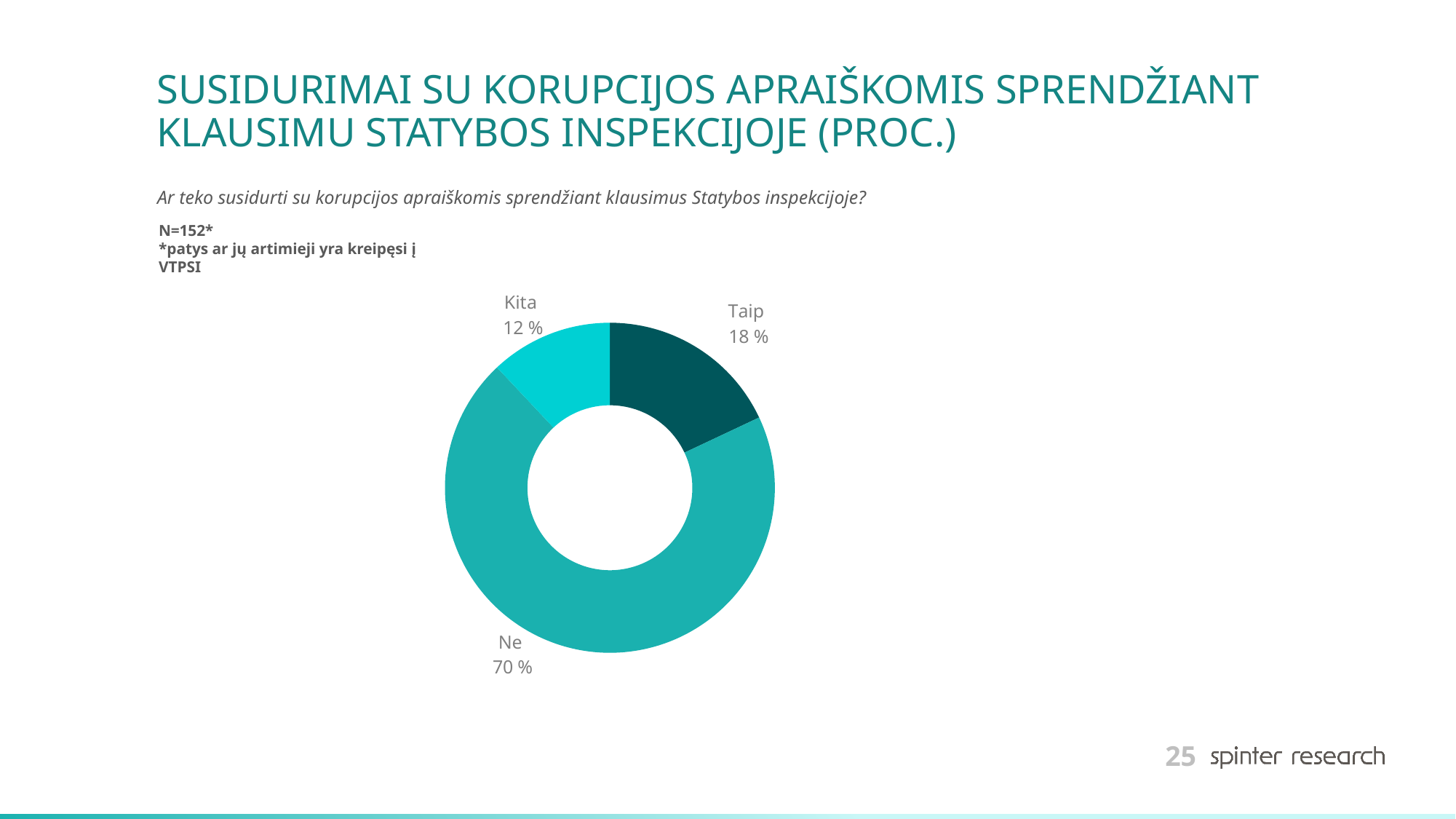
Which category has the largest share of the chart? Ne What is the difference in percentage points between "Taip" and "Kita"? 6 What percentage of respondents answered "Ne"? 70 % What percentage of respondents answered "Kita"? 12 % Which category has the smallest share of the chart? Kita How many categories are shown in the chart? 3 What is the combined share of "Taip" and "Kita"? 30 % What is the sample size (N) stated on the slide? N=152* What is the difference in percentage points between "Ne" and "Taip"? 52 What kind of chart is shown on the slide? Doughnut (pie) chart Which is larger, the share for "Taip" or the share for "Kita"? Taip What percentage of respondents answered "Taip"? 18 %